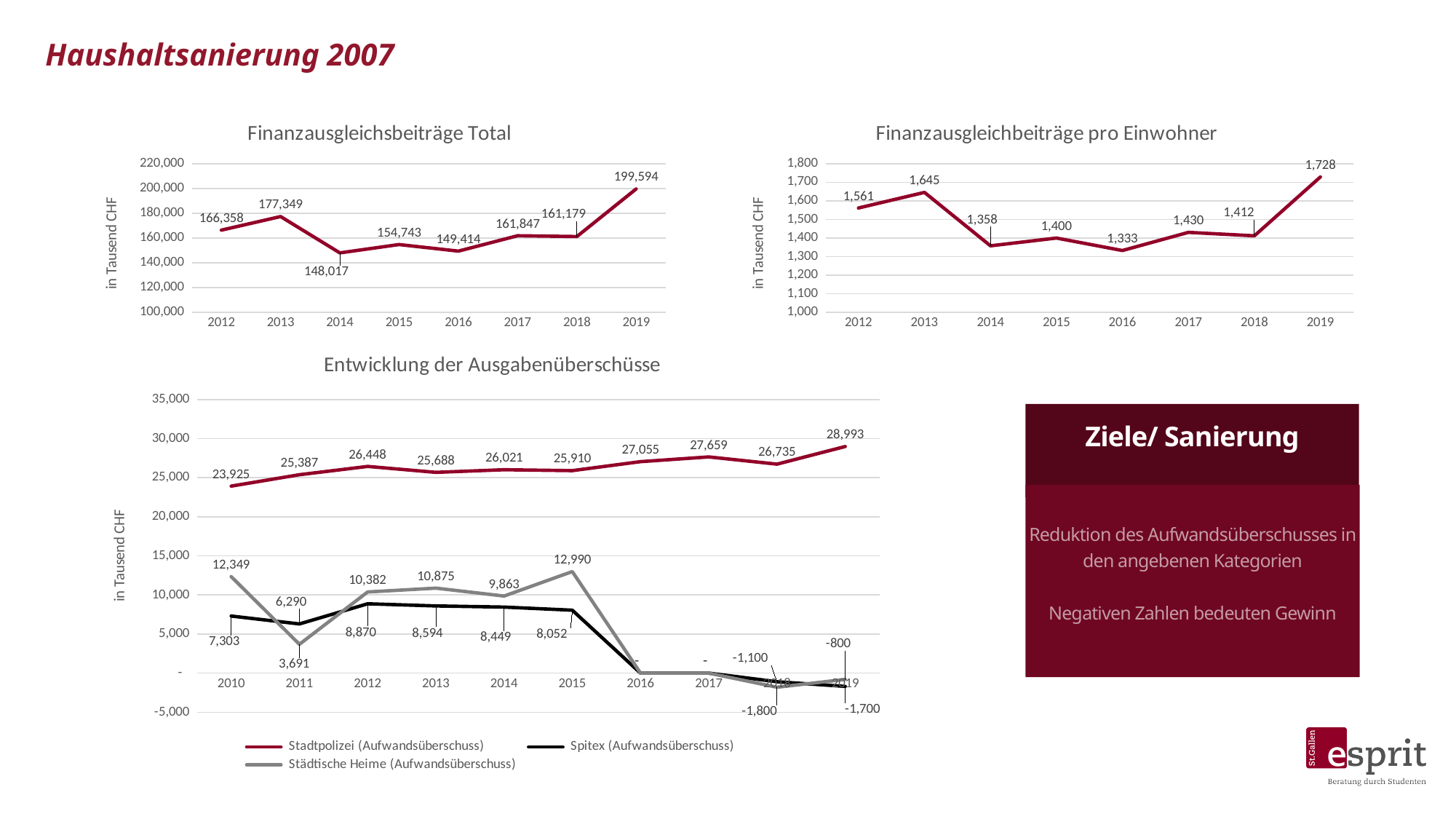
In the chart titled "Finanzausgleichbeiträge pro Einwohner", what is the value for 2016? 1,333 In the chart titled "Entwicklung der Ausgabenüberschüsse", what is the Städtische Heime (Aufwandsüberschuss) value for 2015? 12,990 In the chart titled "Entwicklung der Ausgabenüberschüsse", what is the Stadtpolizei (Aufwandsüberschuss) value for 2010? 23,925 In the chart titled "Finanzausgleichsbeiträge Total", which year has the lowest value? 2014 In the chart titled "Finanzausgleichbeiträge pro Einwohner", is the value for 2013 larger or smaller than the value for 2015? larger How many years are shown on the x axis of the chart titled "Finanzausgleichbeiträge pro Einwohner"? 8 How many series does the legend of the chart titled "Entwicklung der Ausgabenüberschüsse" list? 3 In the chart titled "Finanzausgleichsbeiträge Total", what is the value for 2019? 199,594 In the chart titled "Finanzausgleichbeiträge pro Einwohner", which year has the highest value? 2019 In the chart titled "Entwicklung der Ausgabenüberschüsse", what is the difference between the Spitex (Aufwandsüberschuss) values for 2012 and 2011? 2,580 What kind of chart is the chart titled "Entwicklung der Ausgabenüberschüsse"? line chart In the chart titled "Finanzausgleichsbeiträge Total", what is the difference between the 2013 and 2012 values? 10,991